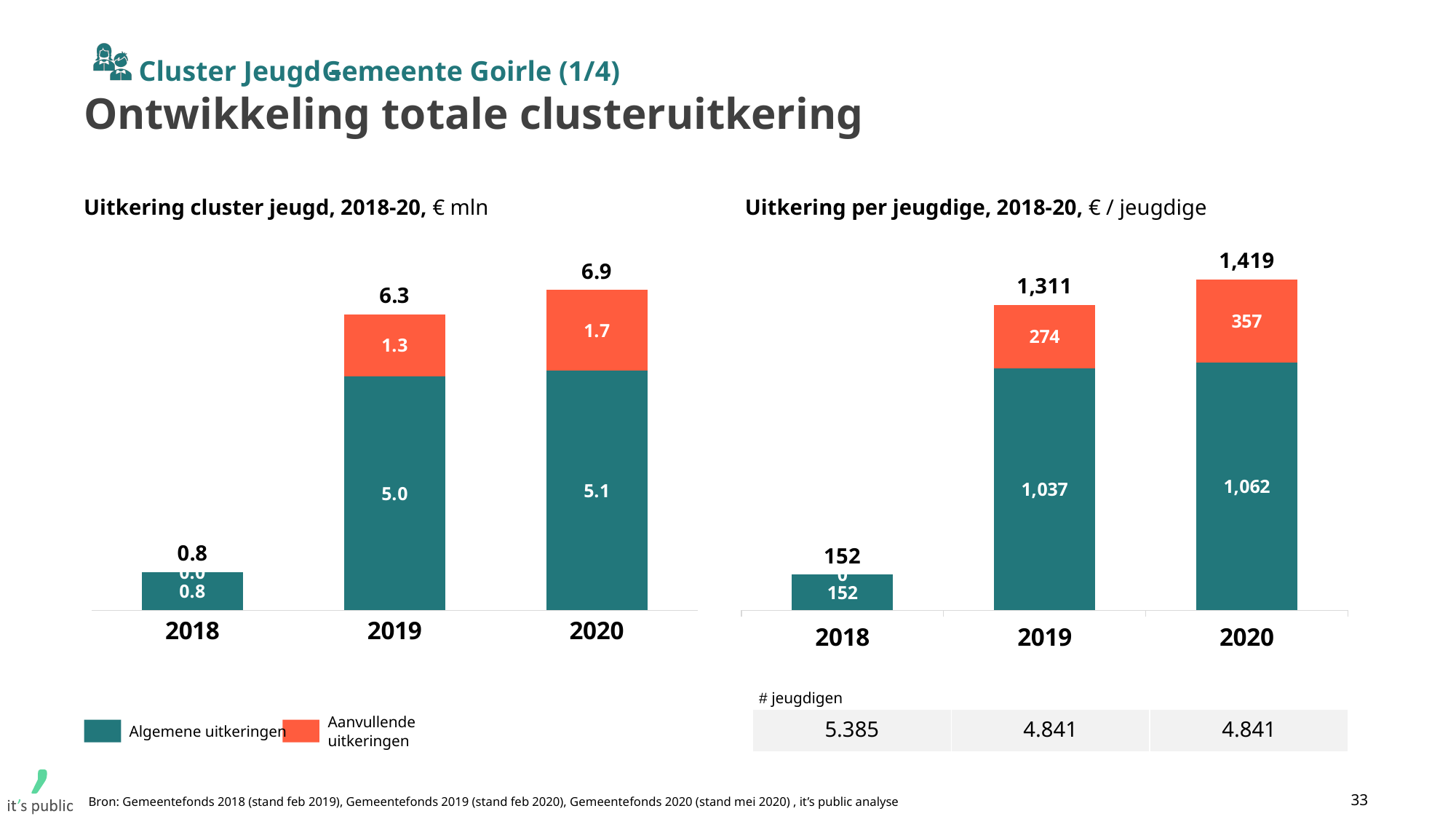
In the chart 'Uitkering cluster jeugd, 2018-20', what is the difference between the totals for 2020 and 2019? 0.6 In the chart 'Uitkering cluster jeugd, 2018-20', what is the total of the stacked bar for 2020? 6.9 In the chart 'Uitkering per jeugdige, 2018-20', what is the value of Algemene uitkeringen for 2020? 1,062 In the chart 'Uitkering per jeugdige, 2018-20', what is the value of Aanvullende uitkeringen for 2019? 274 In the chart 'Uitkering cluster jeugd, 2018-20', what is the value of Aanvullende uitkeringen for 2020? 1.7 In the chart 'Uitkering cluster jeugd, 2018-20', which year has the lowest total? 2018 In the chart 'Uitkering cluster jeugd, 2018-20', what is the value of Algemene uitkeringen for 2019? 5.0 In the chart 'Uitkering per jeugdige, 2018-20', what is the total of the stacked bar for 2019? 1,311 How many series does the legend list for the chart 'Uitkering cluster jeugd, 2018-20'? 2 In the chart 'Uitkering per jeugdige, 2018-20', is the Aanvullende uitkeringen value larger for 2019 or 2020? 2020 In the chart 'Uitkering per jeugdige, 2018-20', which year has the highest total? 2020 What type of chart is 'Uitkering per jeugdige, 2018-20'? Stacked bar chart